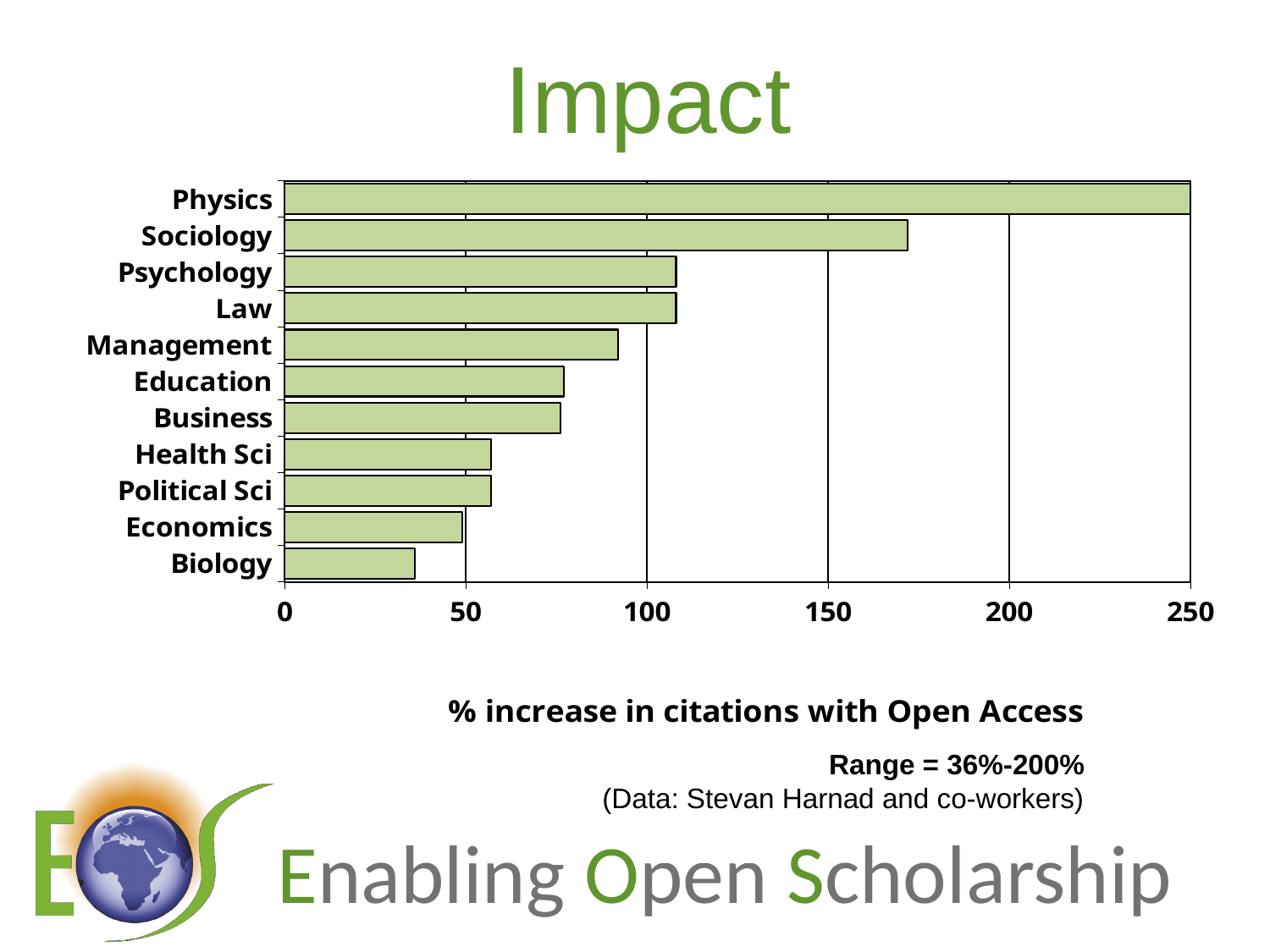
What kind of chart is shown on the slide? bar chart How many disciplines are plotted in the chart? 11 Is the value for Physics greater or less than 200? greater Which discipline has the highest % increase in citations with Open Access? Physics Is the value for Biology greater or less than 50? less Which has the larger value, Sociology or Management? Sociology Which has the larger value, Education or Health Sci? Education What does the chart measure, according to the caption below it? % increase in citations with Open Access Is the value for Sociology greater or less than 150? greater Which discipline has the lowest % increase in citations with Open Access? Biology